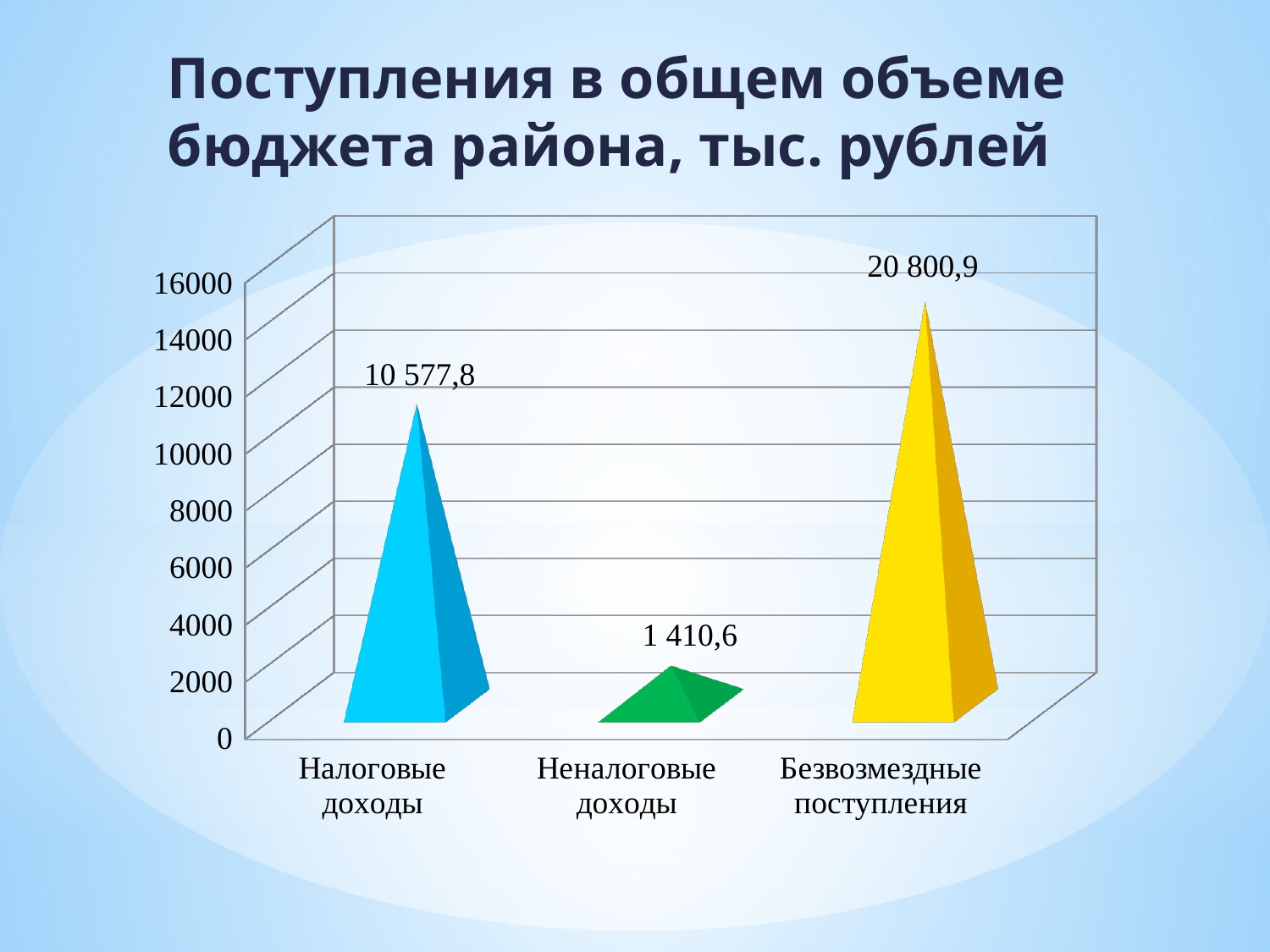
What is the difference between Налоговые доходы and Неналоговые доходы? 9 167,2 Which category has the lowest value? Неналоговые доходы Which is larger, Налоговые доходы or Неналоговые доходы? Налоговые доходы What kind of chart is shown on the slide? bar chart What is the difference between Безвозмездные поступления and Налоговые доходы? 10 223,1 What is the value for Неналоговые доходы? 1 410,6 What is the title of the chart on the slide? Поступления в общем объеме бюджета района, тыс. рублей What is the value for Налоговые доходы? 10 577,8 Which category has the highest value? Безвозмездные поступления Is the value for Неналоговые доходы greater or less than 4000? less What is the value for Безвозмездные поступления? 20 800,9 How many categories are shown on the chart? 3